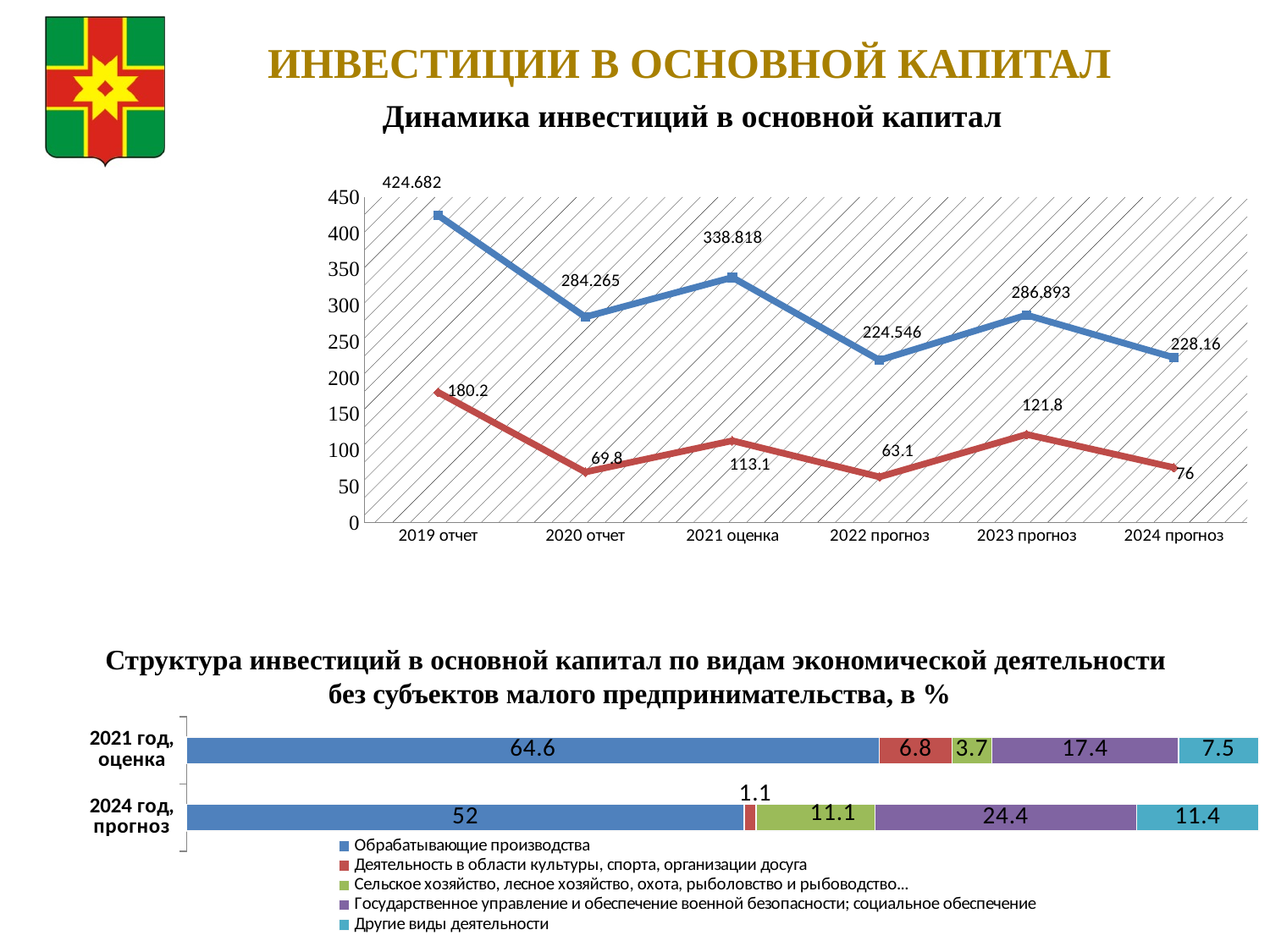
In the chart 'Динамика инвестиций в основной капитал', which x-axis category has the lowest value on the red line? 2022 прогноз In the chart 'Структура инвестиций в основной капитал по видам экономической деятельности', how many series does the legend list? 5 In the chart 'Структура инвестиций в основной капитал по видам экономической деятельности', what is the value for Государственное управление и обеспечение военной безопасности; социальное обеспечение in 2021 год, оценка? 17.4 In the chart 'Динамика инвестиций в основной капитал', how many x-axis categories are shown? 6 In the chart 'Динамика инвестиций в основной капитал', which x-axis category has the highest value on the blue line? 2019 отчет In the chart 'Структура инвестиций в основной капитал по видам экономической деятельности', which is larger: the value for Другие виды деятельности in 2021 год, оценка or in 2024 год, прогноз? 2024 год, прогноз In the chart 'Динамика инвестиций в основной капитал', what is the value of the red line for 2023 прогноз? 121.8 In the chart 'Структура инвестиций в основной капитал по видам экономической деятельности', what is the total of the stacked bar for 2021 год, оценка? 100 What type of chart is 'Динамика инвестиций в основной капитал'? Line chart In the chart 'Динамика инвестиций в основной капитал', what is the difference between the blue line values for 2021 оценка and 2022 прогноз? 114.272 In the chart 'Динамика инвестиций в основной капитал', what is the value of the blue line for 2019 отчет? 424.682 In the chart 'Структура инвестиций в основной капитал по видам экономической деятельности', what is the value for Обрабатывающие производства in 2024 год, прогноз? 52